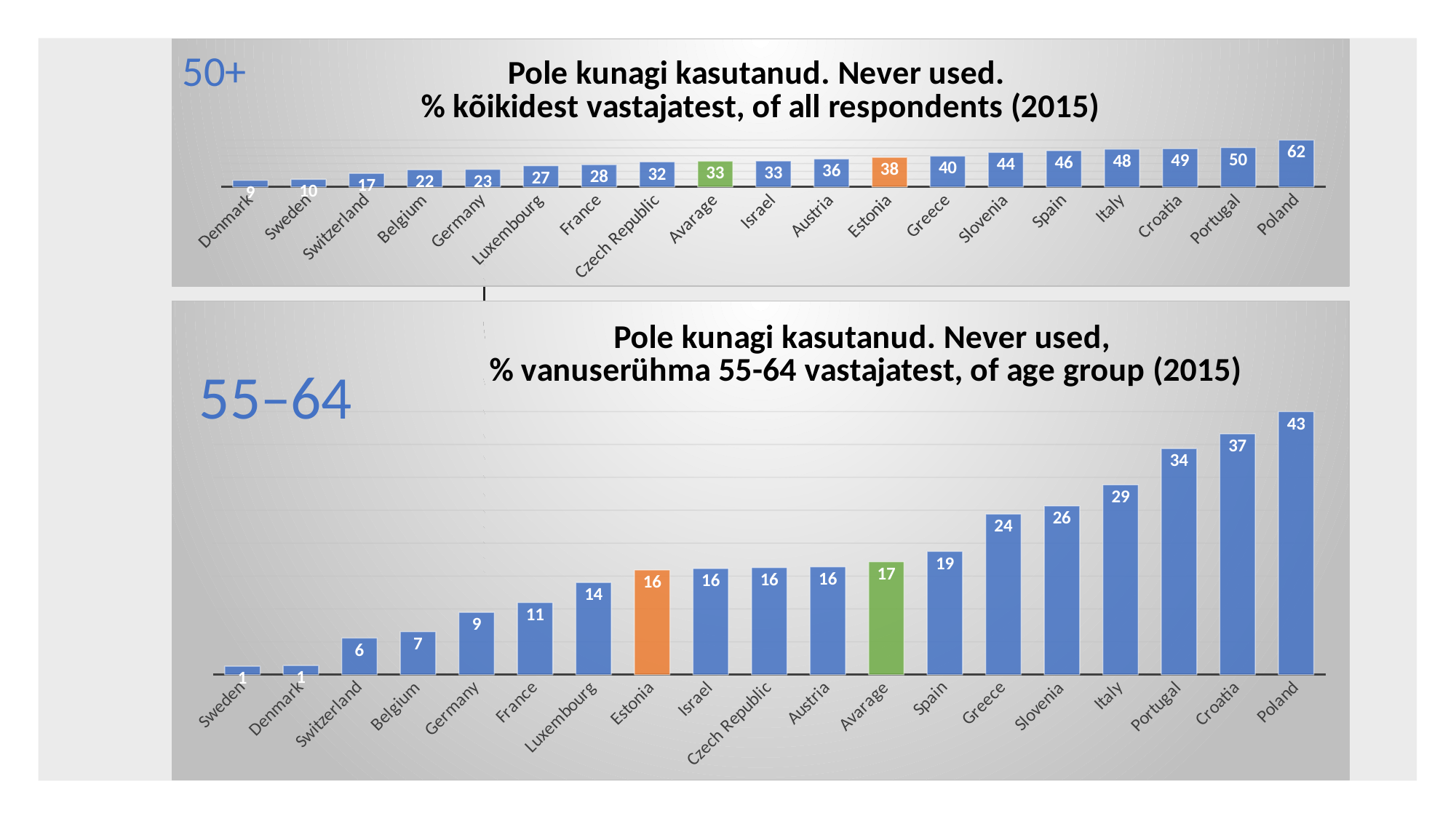
In the bottom chart (55–64), what is the difference between Estonia and Poland? 27 In the bottom chart (55–64), which is larger, Croatia or Portugal? Croatia In the top chart (50+), which country has the highest value? Poland In the bottom chart (55–64), what is the value for Poland? 43 In the top chart (50+), how many bars are plotted? 19 In the top chart (50+), what is the value for Estonia? 38 In the top chart (50+), which country has the lowest value? Denmark What kind of chart is the bottom chart (55–64)? bar chart In the bottom chart (55–64), which country's bar is coloured orange? Estonia In the top chart (50+), what is the difference between Poland and Portugal? 12 In the bottom chart (55–64), what is the value for Avarage? 17 In the bottom chart (55–64), do the values rise or fall from left to right? rise